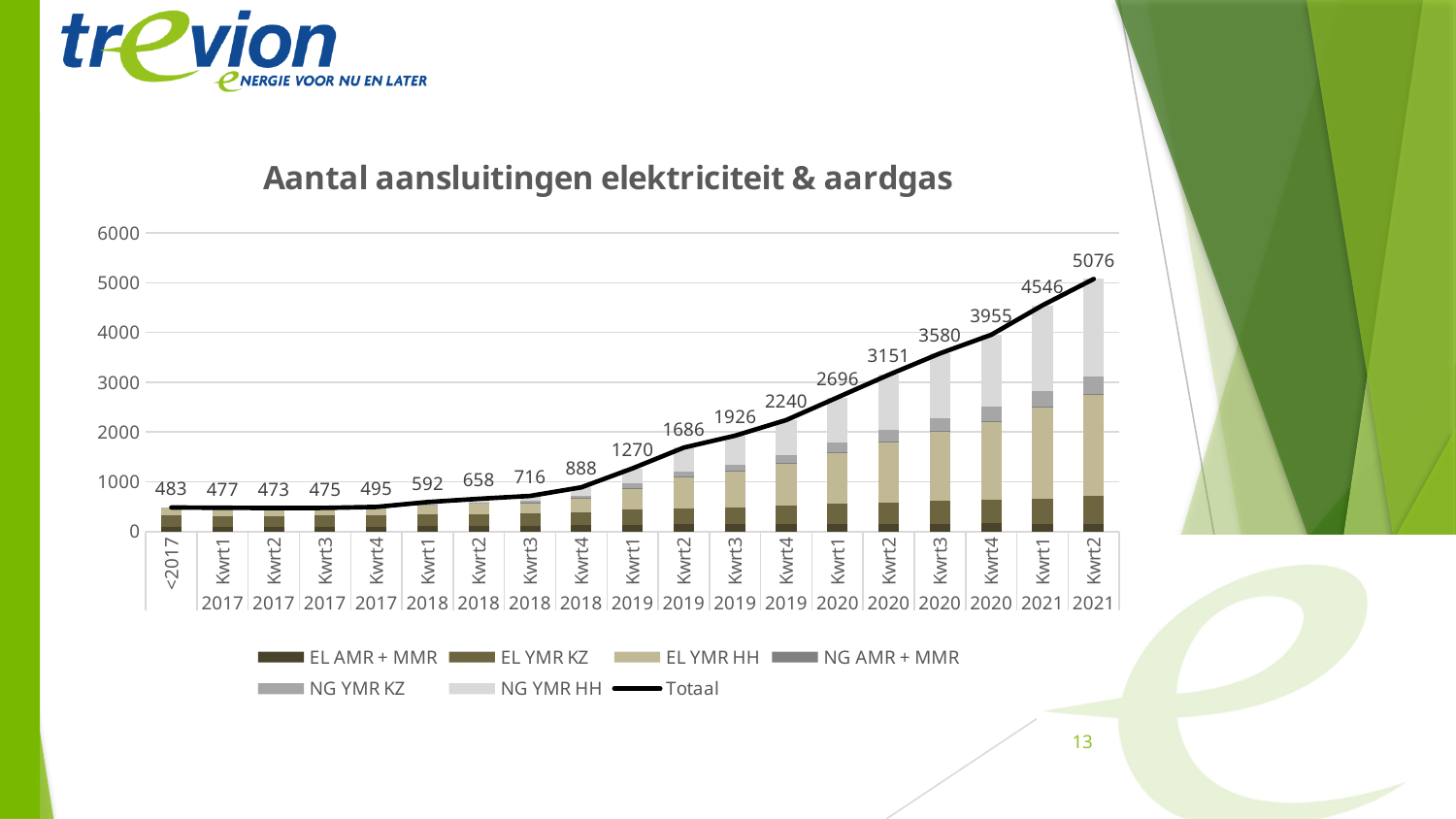
Which is larger, the Totaal value for Kwrt4 2019 or for Kwrt1 2020? Kwrt1 2020 What is the value of the Totaal line for Kwrt1 2019? 1270 How many categories are shown on the x axis? 19 Which category has the highest Totaal value? Kwrt2 2021 How many series does the legend list? 7 What is the value of the Totaal line for the <2017 category? 483 Which category has the lowest Totaal value? Kwrt2 2017 What is the title of the chart? Aantal aansluitingen elektriciteit & aardgas Does the Totaal line rise or fall from Kwrt1 2018 to Kwrt2 2021? Rise What kind of chart is this? Stacked bar chart with a line What is the value of the Totaal line for Kwrt2 2021? 5076 What is the difference between the Totaal values for Kwrt2 2021 and Kwrt1 2021? 530